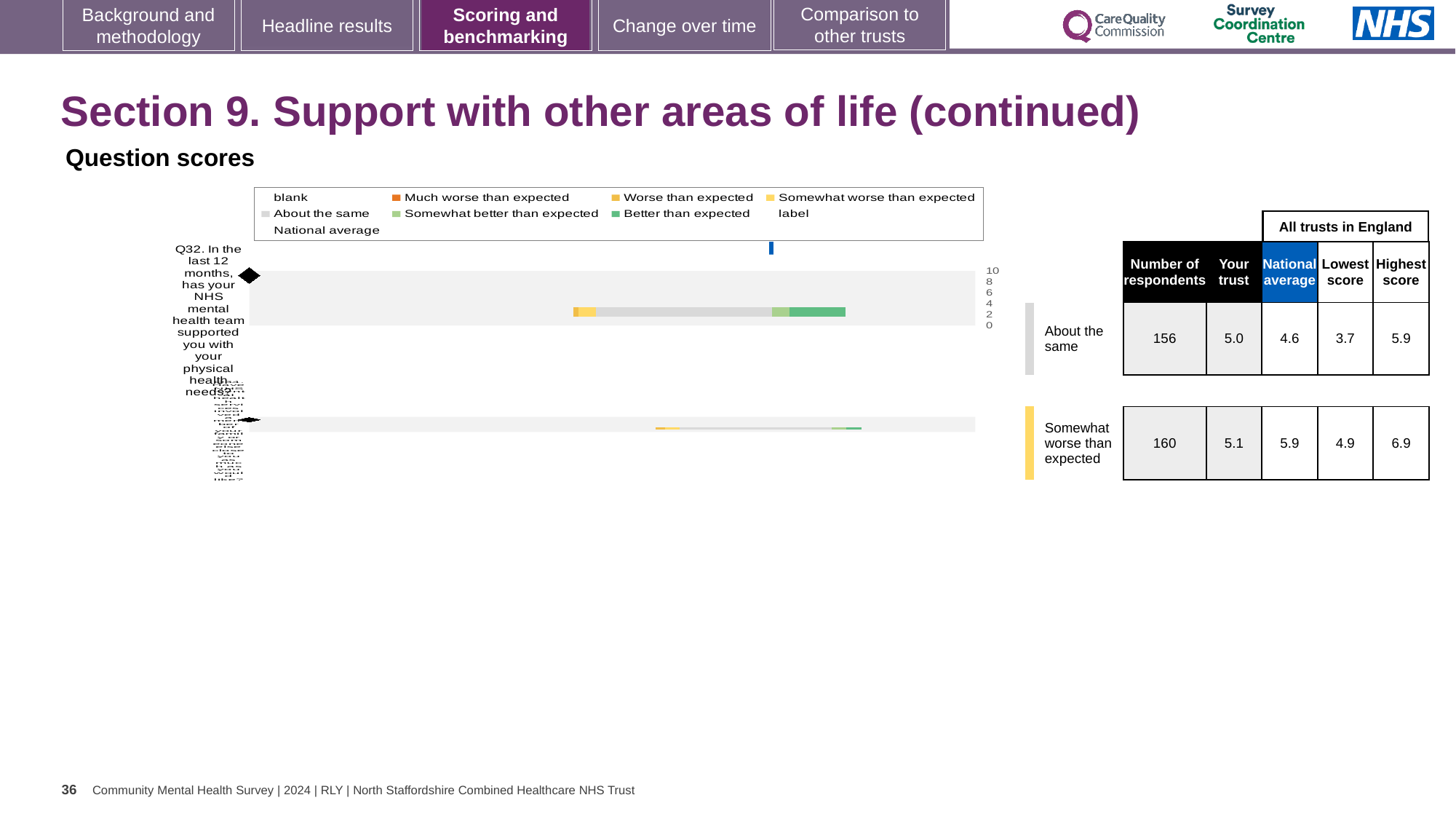
How many respondents answered Q32? 156 What is the national average for the question rated 'Somewhat worse than expected'? 5.9 For Q32, is the trust's score higher or lower than the national average? Higher What is the national average score for Q32? 4.6 What is the 'Your trust' score for the question rated 'Somewhat worse than expected'? 5.1 Which benchmark category is Q32 rated in? About the same What is the difference between the highest and lowest scores for Q32? 2.2 What colour represents 'Much worse than expected' in the chart legend? Orange What is the highest score among all trusts in England for Q32? 5.9 What is the difference between the trust's score and the national average for Q32? 0.4 What is the 'Your trust' score for Q32 (support with physical health needs)? 5.0 What is the lowest score among all trusts in England for Q32? 3.7